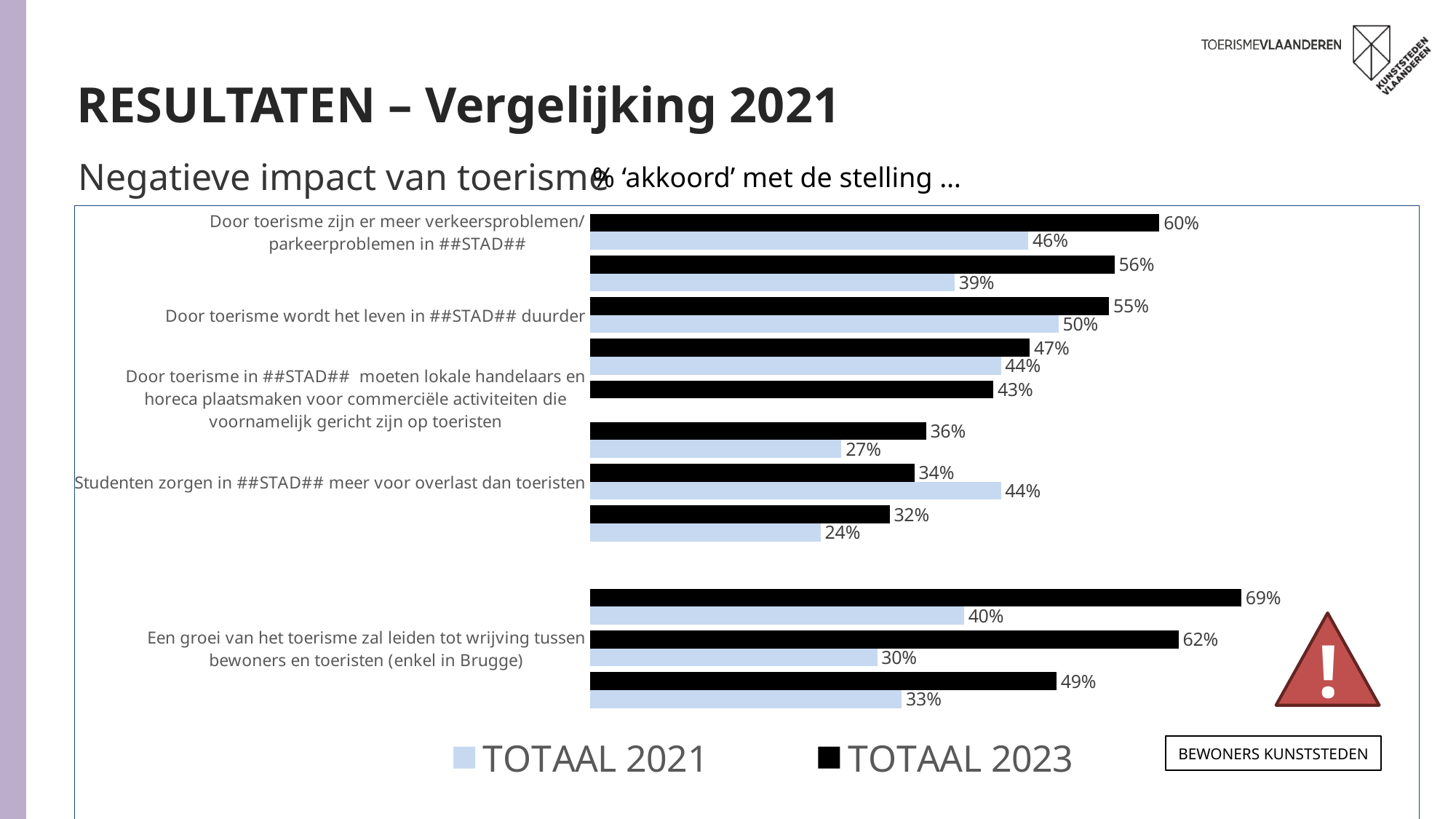
What colour are the TOTAAL 2023 bars? black For 'Studenten zorgen in ##STAD## meer voor overlast dan toeristen', which series has the larger value, TOTAAL 2021 or TOTAAL 2023? TOTAAL 2021 What is the TOTAAL 2021 value for 'Door toerisme zijn er meer verkeersproblemen/parkeerproblemen in ##STAD##'? 46% What is the TOTAAL 2021 value for 'Door toerisme wordt het leven in ##STAD## duurder'? 50% By how many percentage points does the TOTAAL 2023 value exceed the TOTAAL 2021 value for 'Door toerisme zijn er meer verkeersproblemen/parkeerproblemen in ##STAD##'? 14 percentage points What is the highest value shown on any bar in the chart? 69% What kind of chart is shown on the slide? bar chart What is the TOTAAL 2023 value for 'Door toerisme zijn er meer verkeersproblemen/parkeerproblemen in ##STAD##'? 60% How many series does the legend list? 2 What is the lowest value shown on any bar in the chart? 24% What is the TOTAAL 2023 value for 'Een groei van het toerisme zal leiden tot wrijving tussen bewoners en toeristen (enkel in Brugge)'? 62% What are the two series named in the legend? TOTAAL 2021 and TOTAAL 2023